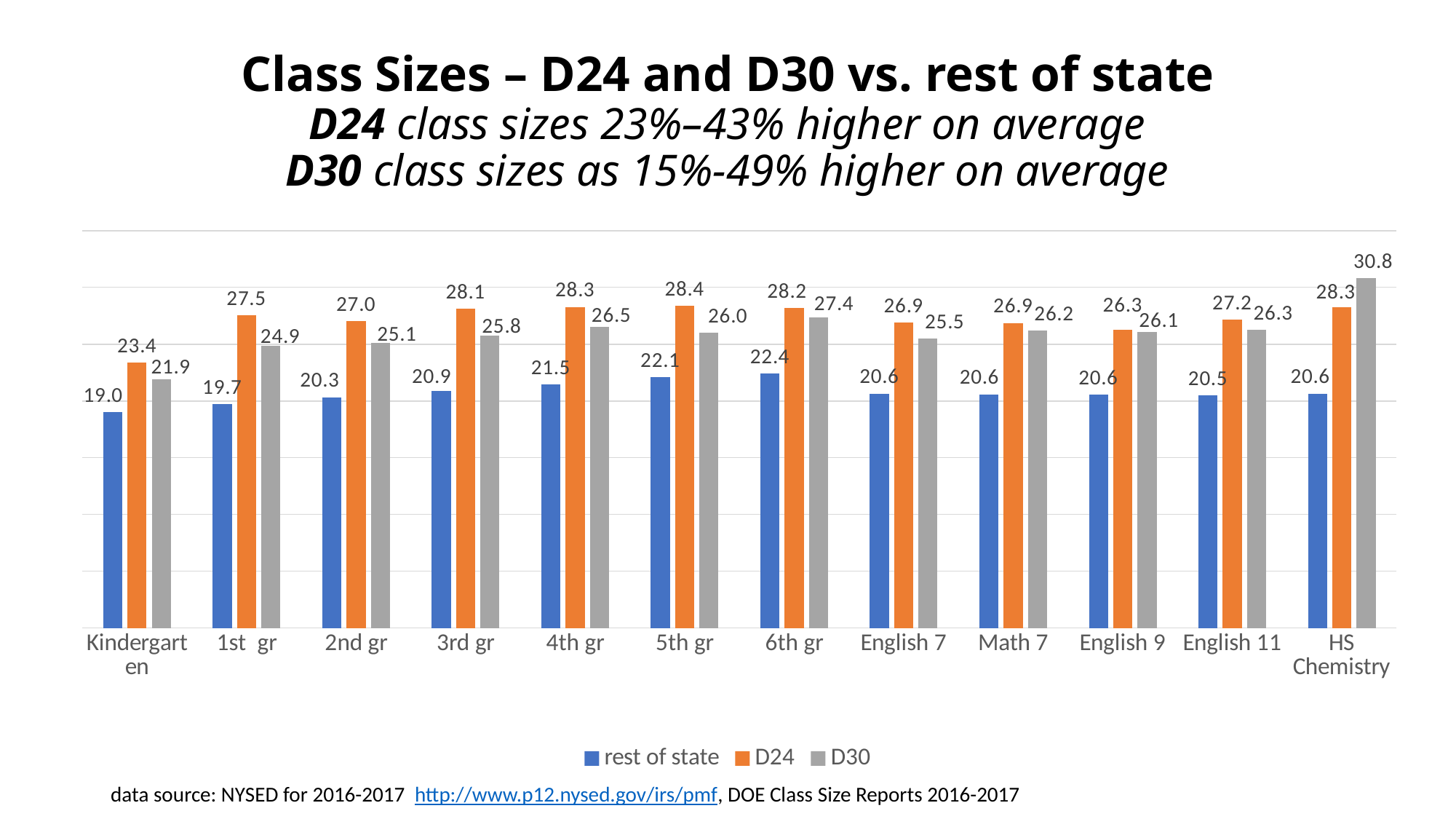
What is the D30 class size for HS Chemistry? 30.8 What is the difference between the D30 and rest of state class sizes for HS Chemistry? 10.2 Which category has the lowest rest of state class size? Kindergarten How many series does the legend list? 3 What is the rest of state class size for Kindergarten? 19.0 For 6th gr, which is larger: the D24 class size or the D30 class size? D24 What kind of chart is shown on the slide? Bar chart How many categories are shown on the x axis? 12 Which category has the highest rest of state class size? 6th gr What is the D24 class size for 3rd gr? 28.1 What is the difference between the D24 and D30 class sizes for Kindergarten? 1.5 Which category has the highest D30 class size? HS Chemistry